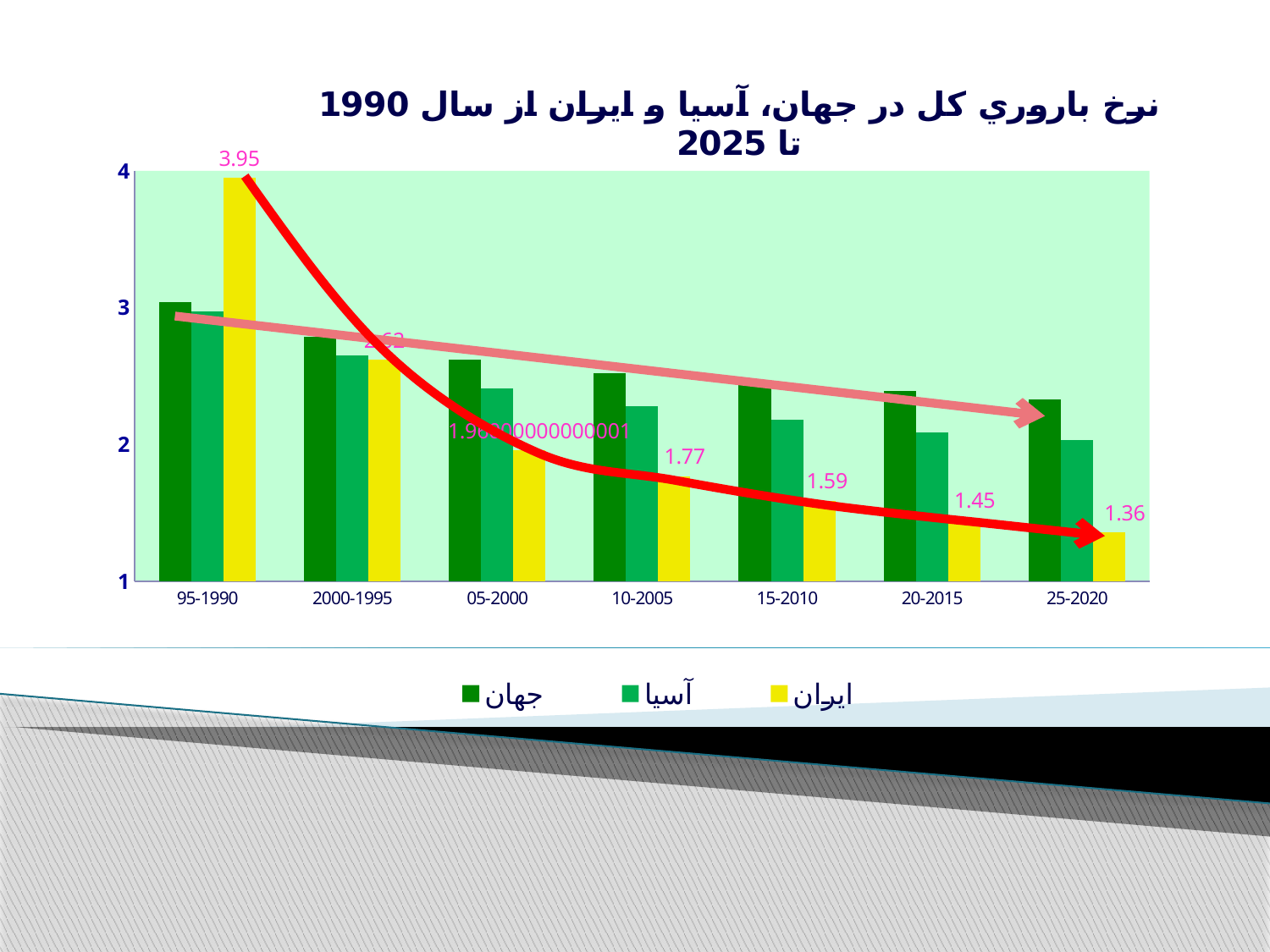
What is the value for ایران in the 25-2020 period? 1.36 What is the value for ایران in the 15-2010 period? 1.59 Which is larger for ایران: the value for 10-2005 or the value for 20-2015? 10-2005 What is the difference between the ایران values for 95-1990 and 25-2020? 2.59 How many series does the legend list? 3 How many periods are shown on the x axis? 7 Do the values for ایران rise or fall from 95-1990 to 25-2020? fall In which period is the value for ایران highest? 95-1990 Is the value for جهان in the 25-2020 period greater or less than 2? greater What is the value for ایران in the 10-2005 period? 1.77 What is the value for ایران in the 95-1990 period? 3.95 In which period is the value for ایران lowest? 25-2020